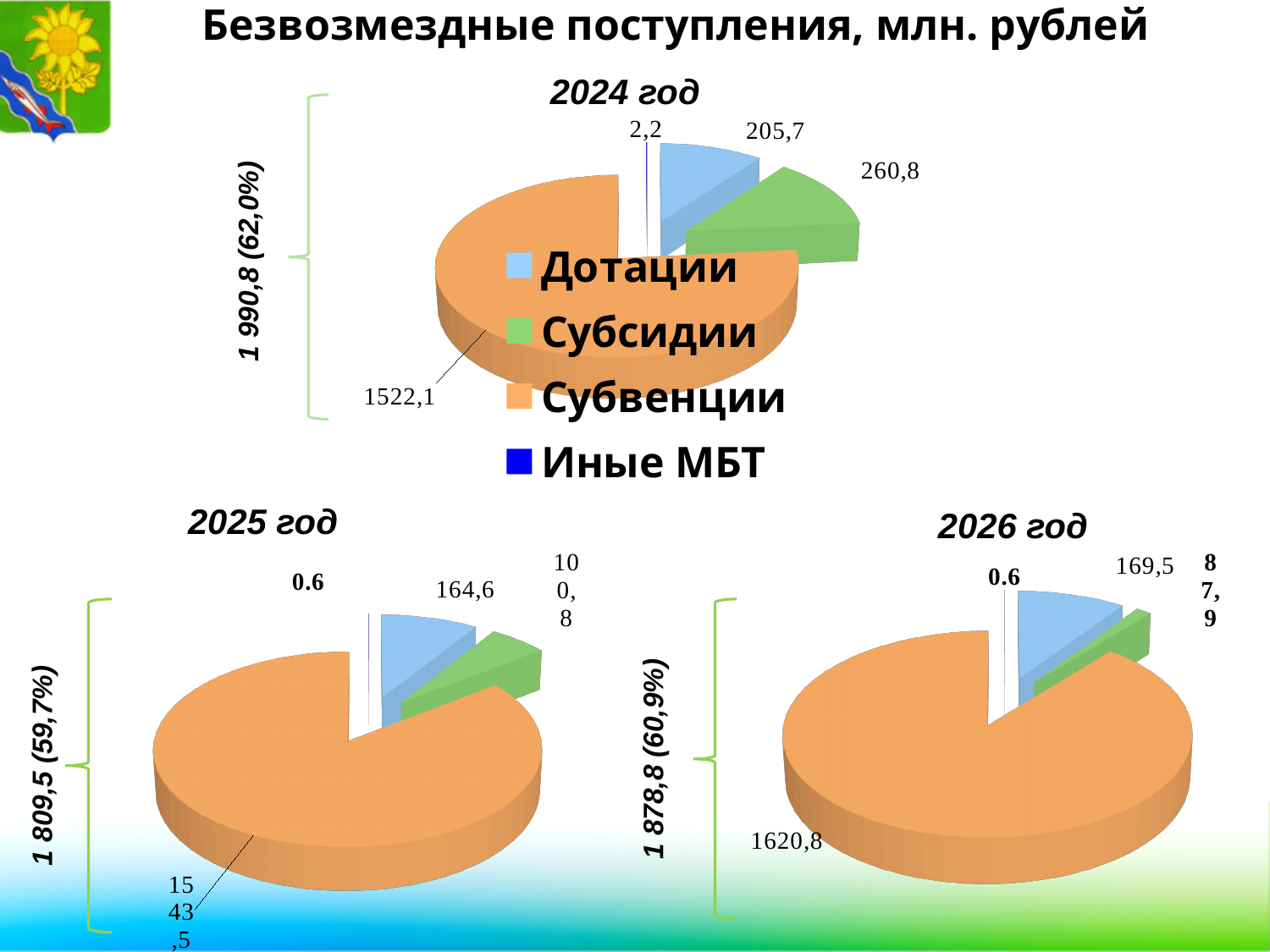
On the 2024 год chart, which category has the smallest slice? Иные МБТ On the 2024 год chart, what is the value for Субвенции? 1522,1 On the 2024 год chart, what is the difference between the values for Субсидии and Дотации? 55,1 How many series does the legend list? 4 On the 2024 год chart, which category has the largest slice? Субвенции What kind of chart is the 2025 год chart? Pie chart Which chart shows a larger value for Субвенции, the 2024 год chart or the 2026 год chart? 2026 год On the 2026 год chart, what is the value for Дотации? 169,5 On the 2026 год chart, what is the value for Субвенции? 1620,8 On the 2024 год chart, what is the value for Субсидии? 260,8 On the 2024 год chart, what is the value for Дотации? 205,7 On the 2025 год chart, what is the value for Дотации? 164,6